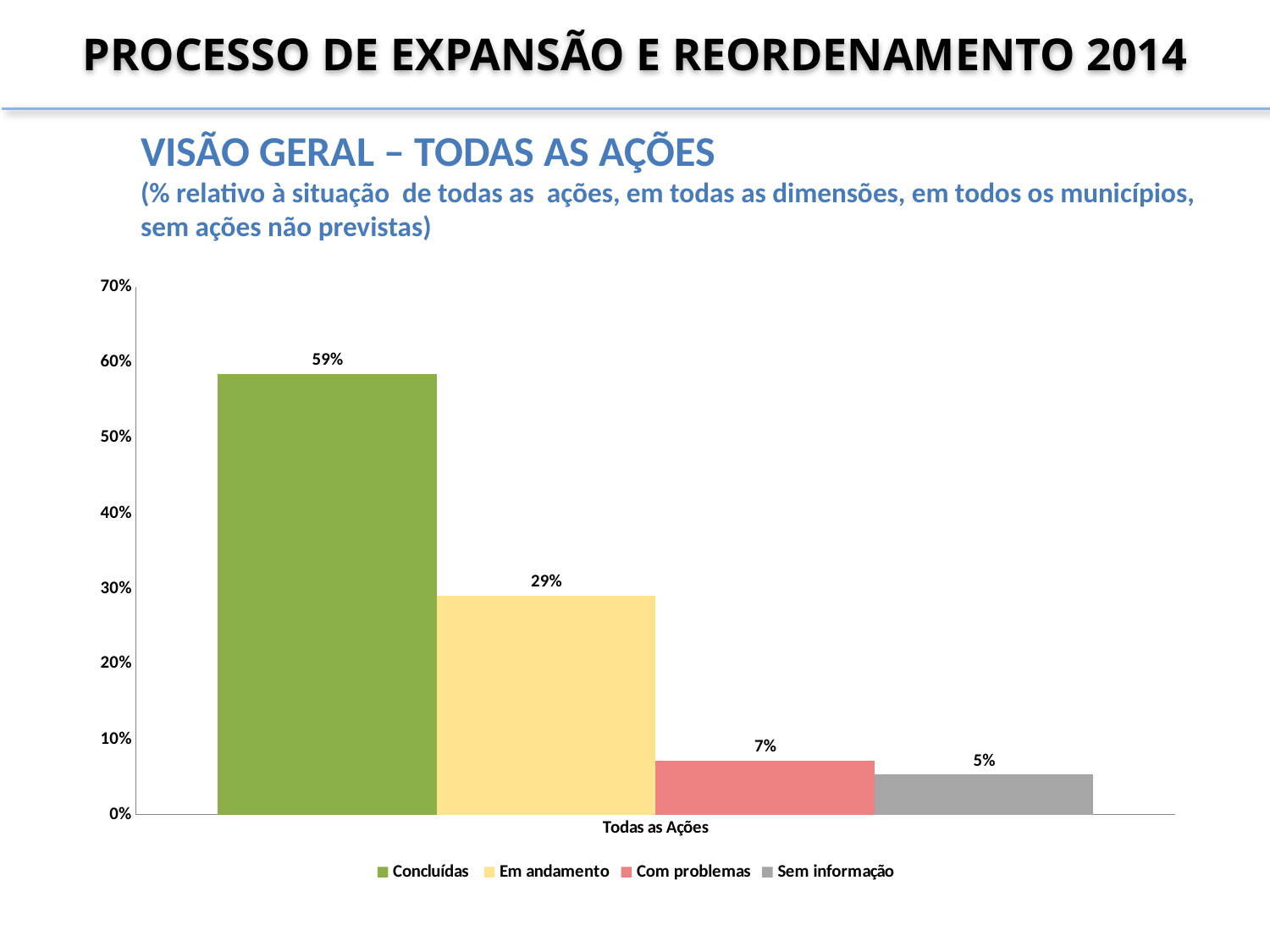
Which is larger, the value for Em andamento or the value for Com problemas? Em andamento Which series has the lowest value? Sem informação What is the label of the category on the x axis? Todas as Ações What is the value for Concluídas? 59% What is the value for Sem informação? 5% What is the value for Em andamento? 29% What kind of chart is shown on the slide? Bar chart What is the difference between the values for Concluídas and Em andamento? 30% What is the difference between the values for Com problemas and Sem informação? 2% Which series has the highest value? Concluídas What is the value for Com problemas? 7% How many series does the legend list? 4